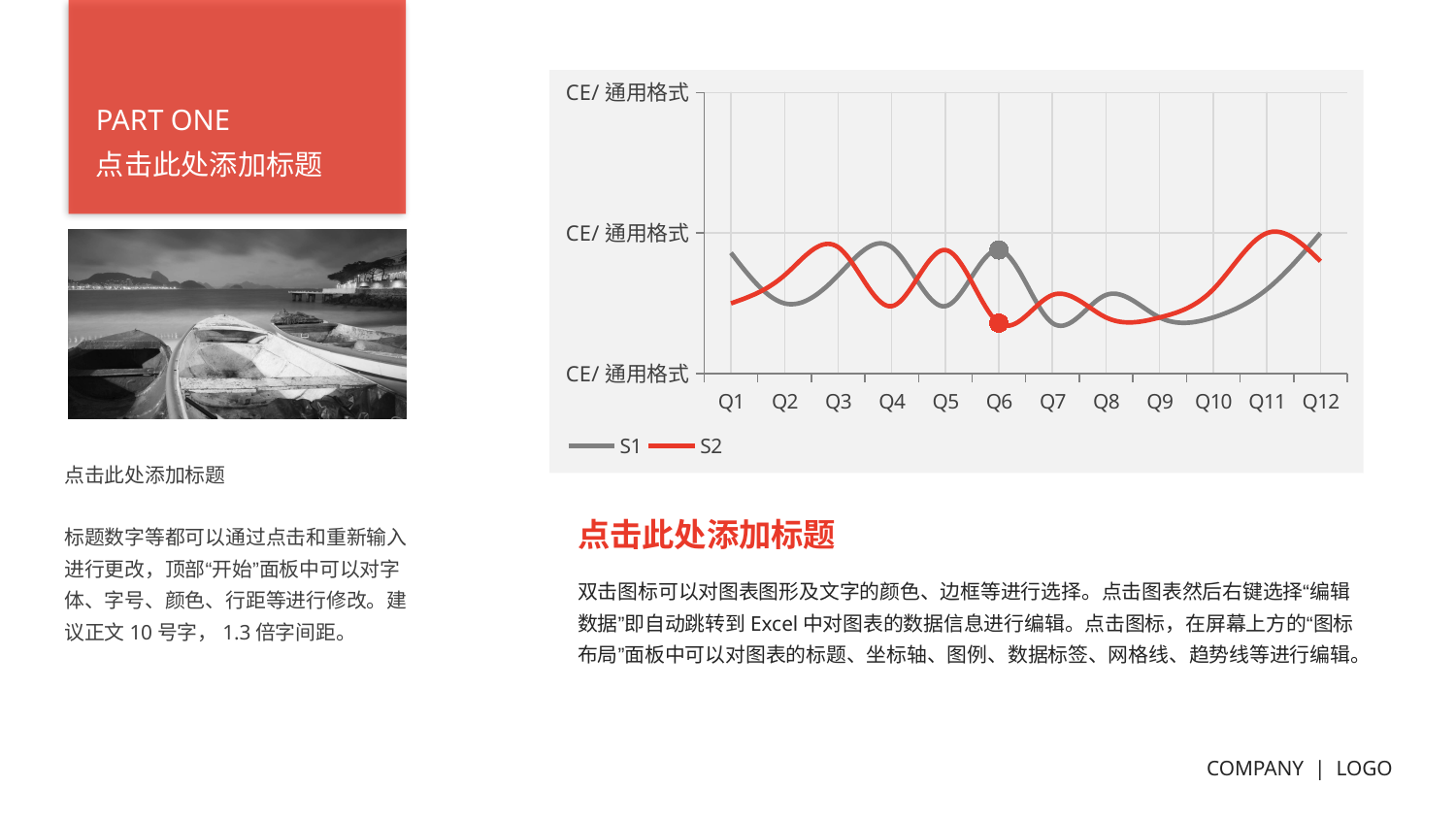
At Q6, which series has the higher value, S1 or S2? S1 What is the first category label on the x axis? Q1 How many categories are shown on the x axis of the chart? 12 At Q1, which series has the higher value, S1 or S2? S1 For series S1, which category has the highest value? Q12 At Q2, which series has the higher value, S1 or S2? S2 How many series does the chart legend list? 2 Does series S1 rise or fall from Q10 to Q12? rise What kind of chart is shown on the slide? line chart What are the names of the series in the chart legend? S1 and S2 For series S2, which category has the highest value? Q11